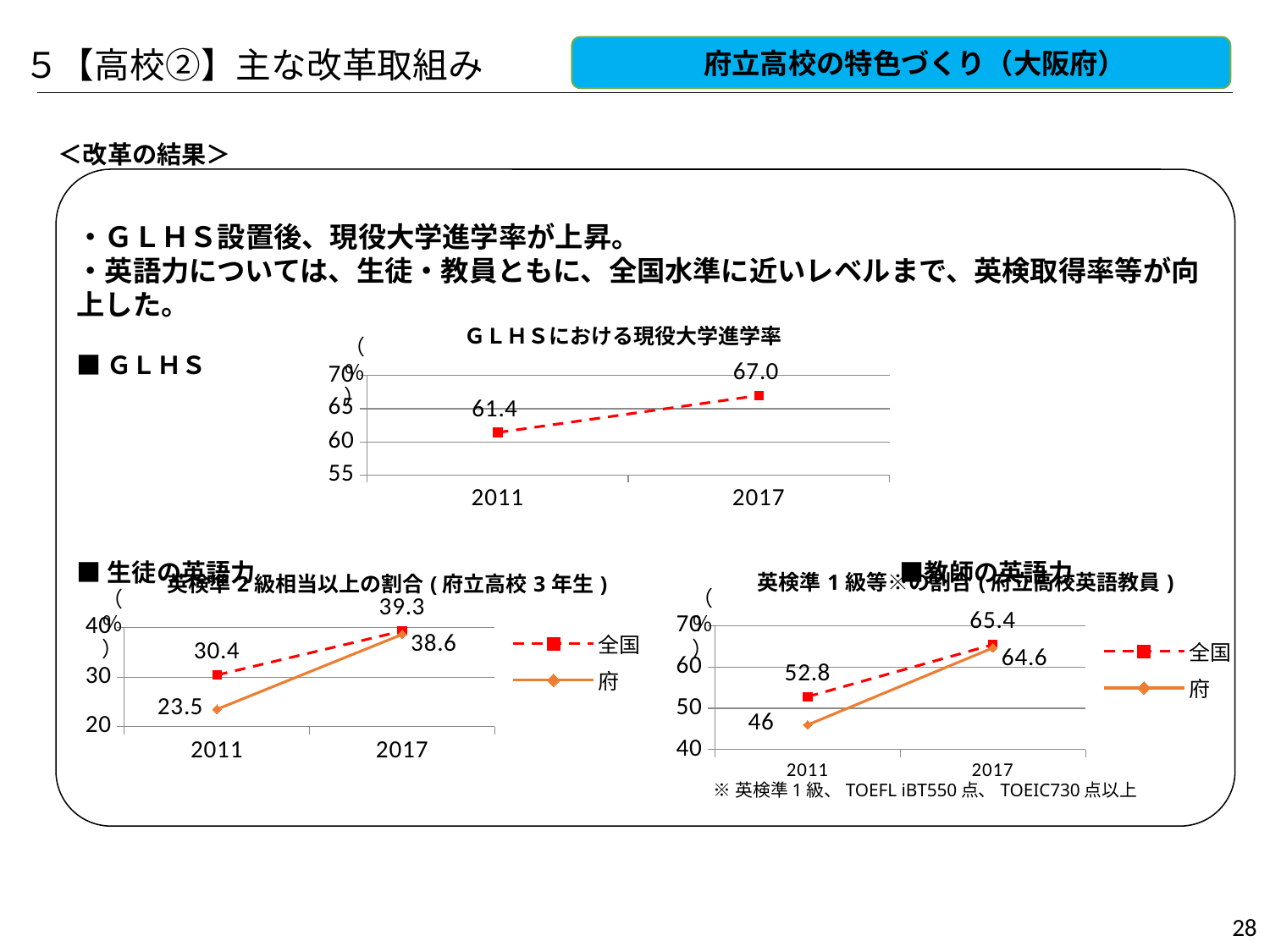
In the chart titled 英検準１級等※の割合(府立高校英語教員), which series has the higher value in 2011, 全国 or 府? 全国 What kind of chart is the one titled 英検準１級等※の割合(府立高校英語教員)? line chart In the chart titled 英検準２級相当以上の割合(府立高校３年生), how many series does the legend list? 2 In the chart titled ＧＬＨＳにおける現役大学進学率, what is the value for 2011? 61.4 In the chart titled 英検準１級等※の割合(府立高校英語教員), what is the value for 全国 in 2017? 65.4 In the chart titled ＧＬＨＳにおける現役大学進学率, does the value rise or fall from 2011 to 2017? rise In the chart titled ＧＬＨＳにおける現役大学進学率, by how much did the value increase from 2011 to 2017? 5.6 In the chart titled 英検準１級等※の割合(府立高校英語教員), what is the value for 府 in 2011? 46 In the chart titled ＧＬＨＳにおける現役大学進学率, what is the value for 2017? 67.0 In the chart titled 英検準２級相当以上の割合(府立高校３年生), what is the value for 全国 in 2017? 39.3 In the chart titled 英検準２級相当以上の割合(府立高校３年生), what is the value for 府 in 2011? 23.5 In the chart titled 英検準２級相当以上の割合(府立高校３年生), what is the difference between 全国 and 府 in 2011? 6.9